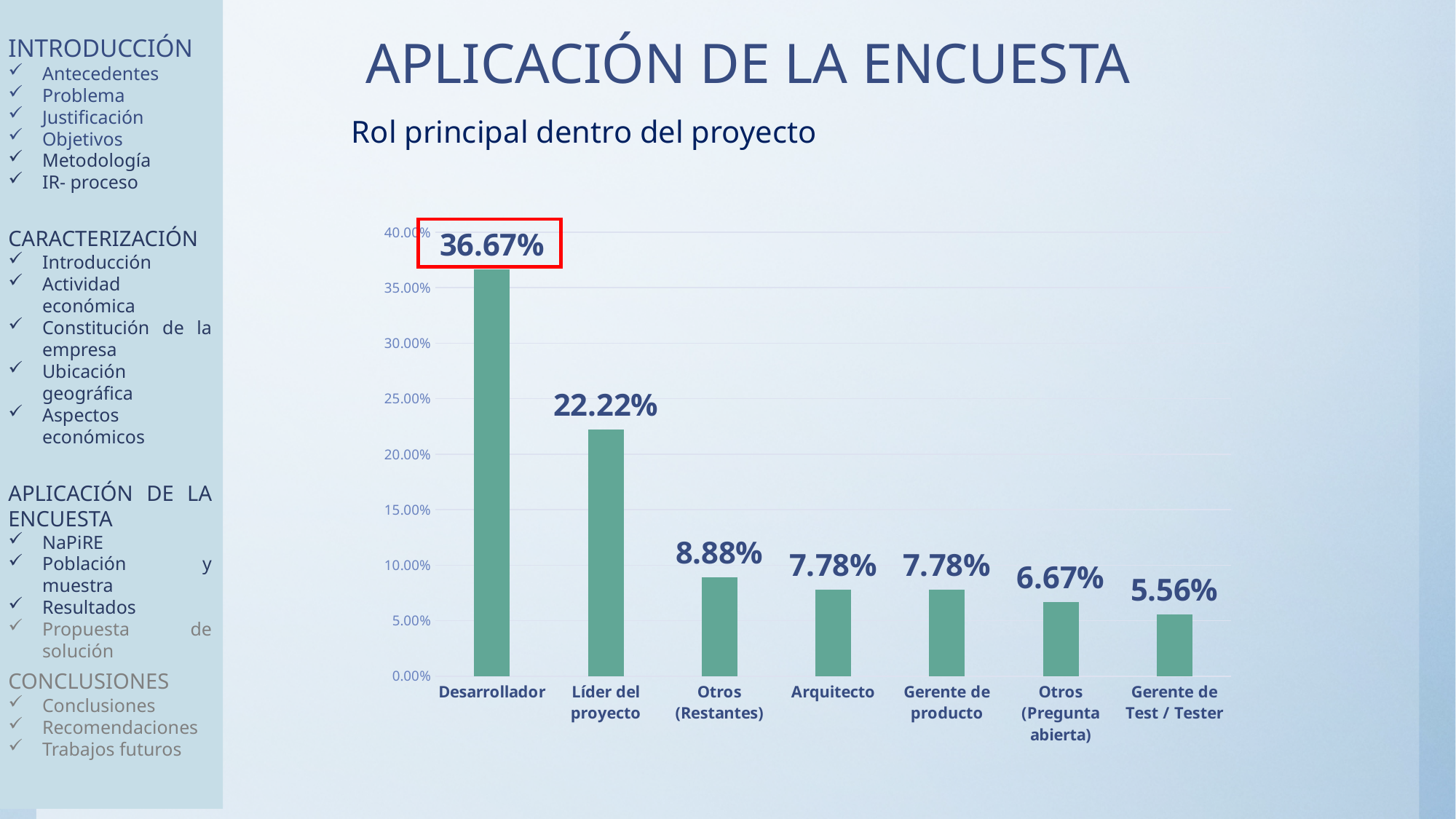
What is the subtitle of the chart? Rol principal dentro del proyecto What is the difference between the values for Desarrollador and Líder del proyecto? 14.45% What is the value for Líder del proyecto? 22.22% How many categories are shown on the x axis? 7 What is the value for Desarrollador? 36.67% Is the value for Líder del proyecto greater or less than 20.00%? greater What is the value for Gerente de Test / Tester? 5.56% What is the value for Arquitecto? 7.78% Which is larger, the value for Otros (Restantes) or the value for Otros (Pregunta abierta)? Otros (Restantes) Which category has the highest value? Desarrollador Which category has the lowest value? Gerente de Test / Tester What kind of chart is shown on the slide? bar chart